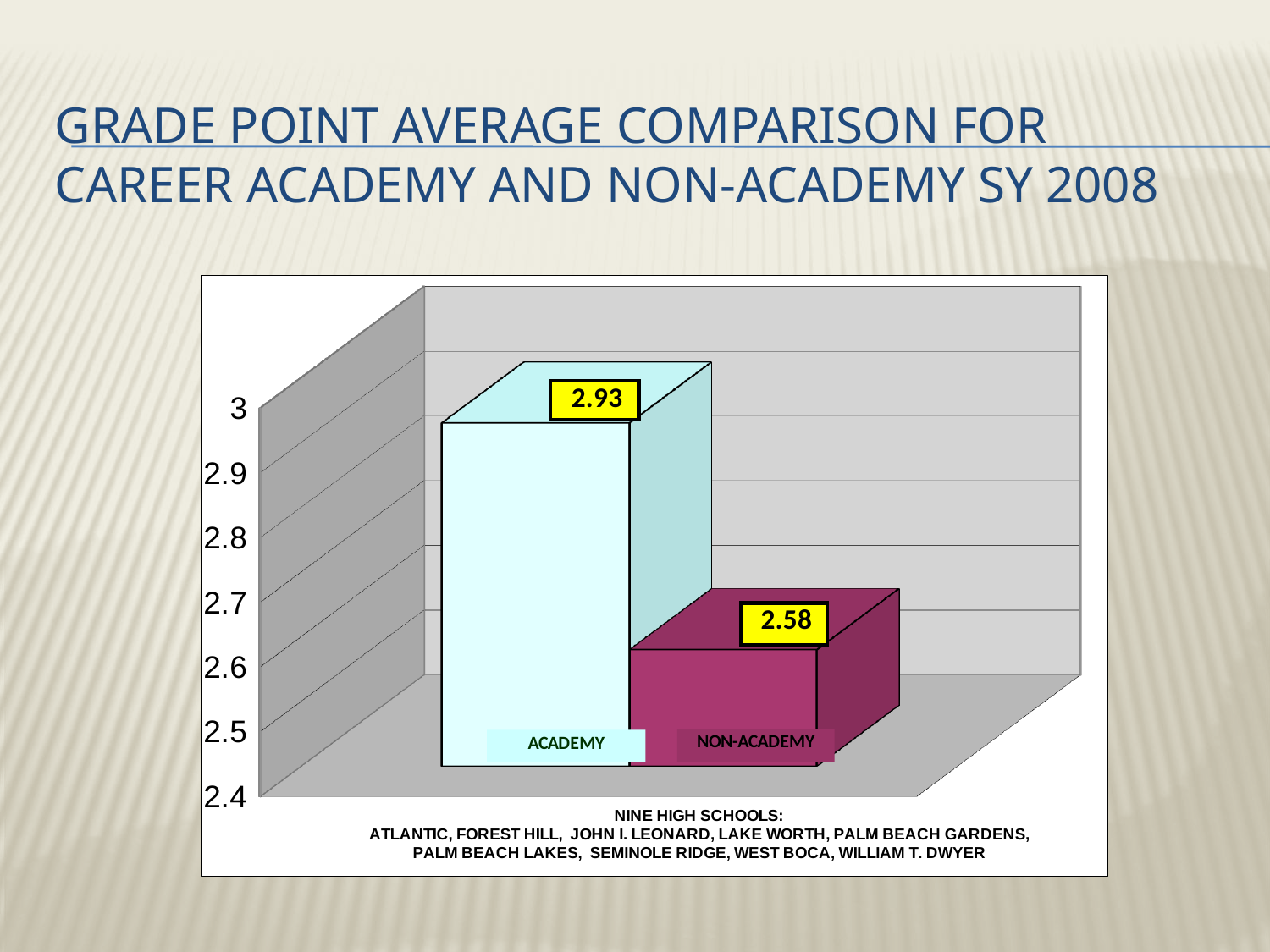
Is the Academy grade point average larger than the Non-Academy grade point average? Yes Which category has the higher grade point average? Academy What is the lowest value shown on the vertical axis? 2.4 Which category has the lower grade point average? Non-Academy What kind of chart is shown on the slide? Bar chart What is the grade point average for Non-Academy? 2.58 What is the difference between the Academy and Non-Academy grade point averages? 0.35 How many categories are plotted in the chart? 2 Is the value for Academy greater or less than 2.8? greater How many high schools does the chart's footnote say are included? Nine Is the value for Non-Academy greater or less than 2.7? less What is the grade point average for Academy? 2.93